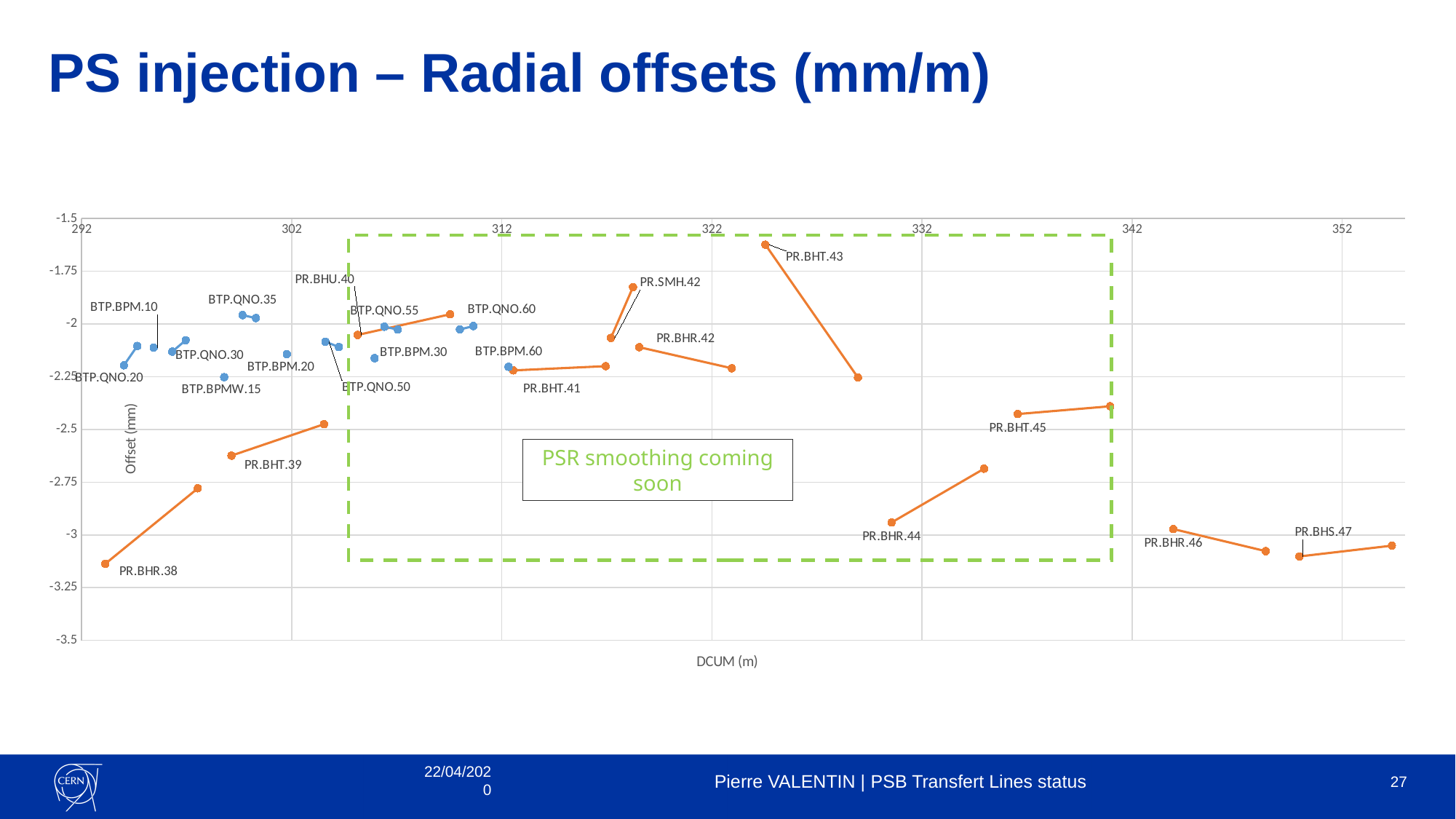
Which has a higher offset, PR.BHT.43 or PR.BHR.44? PR.BHT.43 What kind of chart is shown on the slide? Scatter chart with lines Are the points of PR.BHS.47 greater or less than -2.75 mm? less Is the upper point of PR.SMH.42 greater or less than -2 mm? greater Is the upper point of PR.BHT.43 greater or less than -1.75 mm? greater What is the label of the horizontal axis of the chart? DCUM (m) Which has a lower offset, PR.BHR.38 or BTP.QNO.35? PR.BHR.38 What text appears in the box inside the green dashed rectangle on the chart? PSR smoothing coming soon Which labelled element has the highest (least negative) offset on the chart? PR.BHT.43